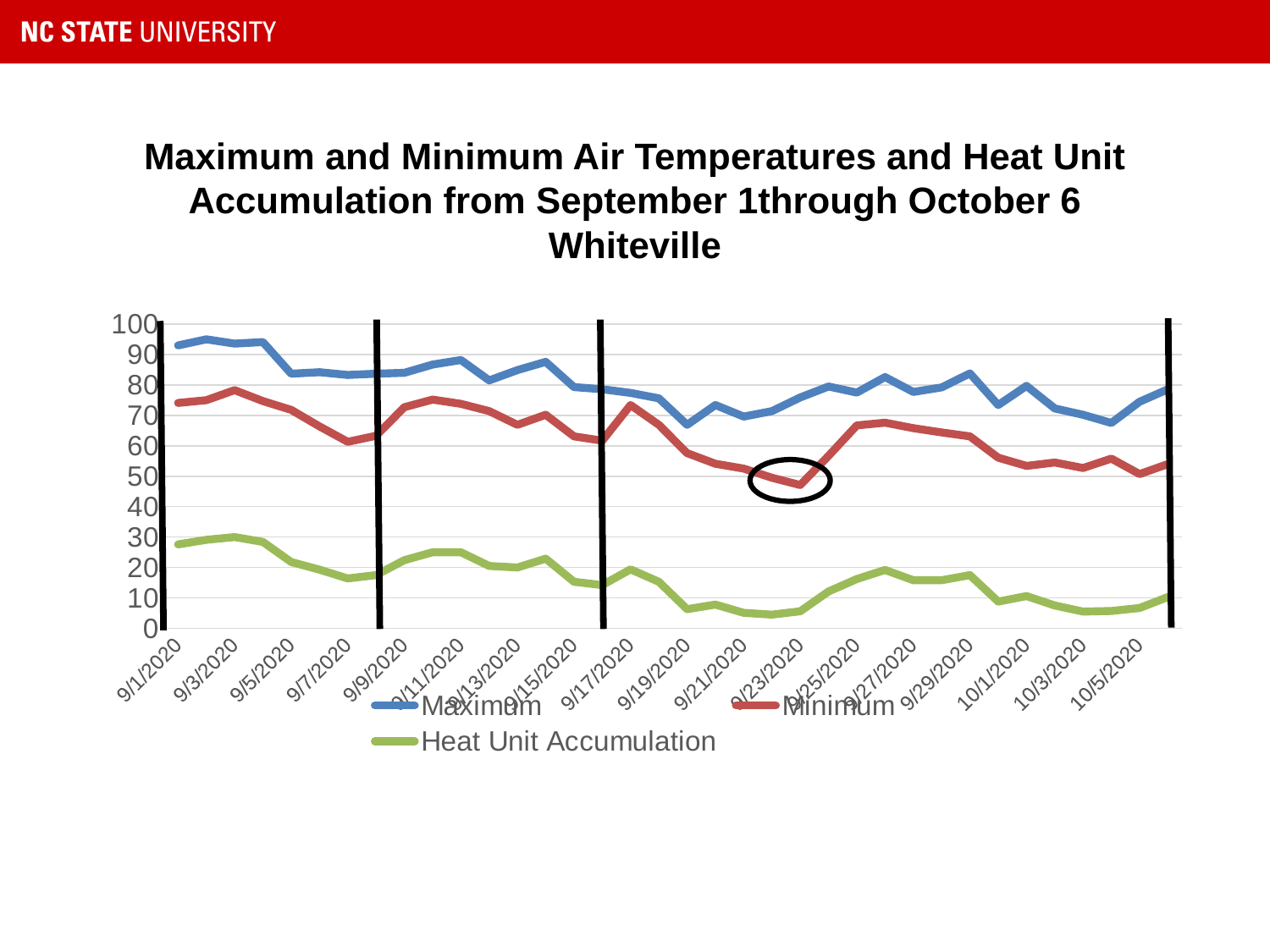
Does the Maximum line rise or fall from 9/1/2020 to 9/7/2020? Fall Is the Maximum value on 9/1/2020 greater or less than 90? greater What are the three series named in the legend? Maximum, Minimum, Heat Unit Accumulation Is the Maximum value on 9/19/2020 greater or less than 80? less How many series does the legend list? 3 What kind of chart is shown on the slide? Line chart Is the Minimum value on 9/23/2020 greater or less than 60? less Which series has the highest values across the whole chart? Maximum Which series has the lowest values across the whole chart? Heat Unit Accumulation On 9/1/2020, which is larger, the Maximum or the Minimum value? Maximum What colour is the Minimum line? Red